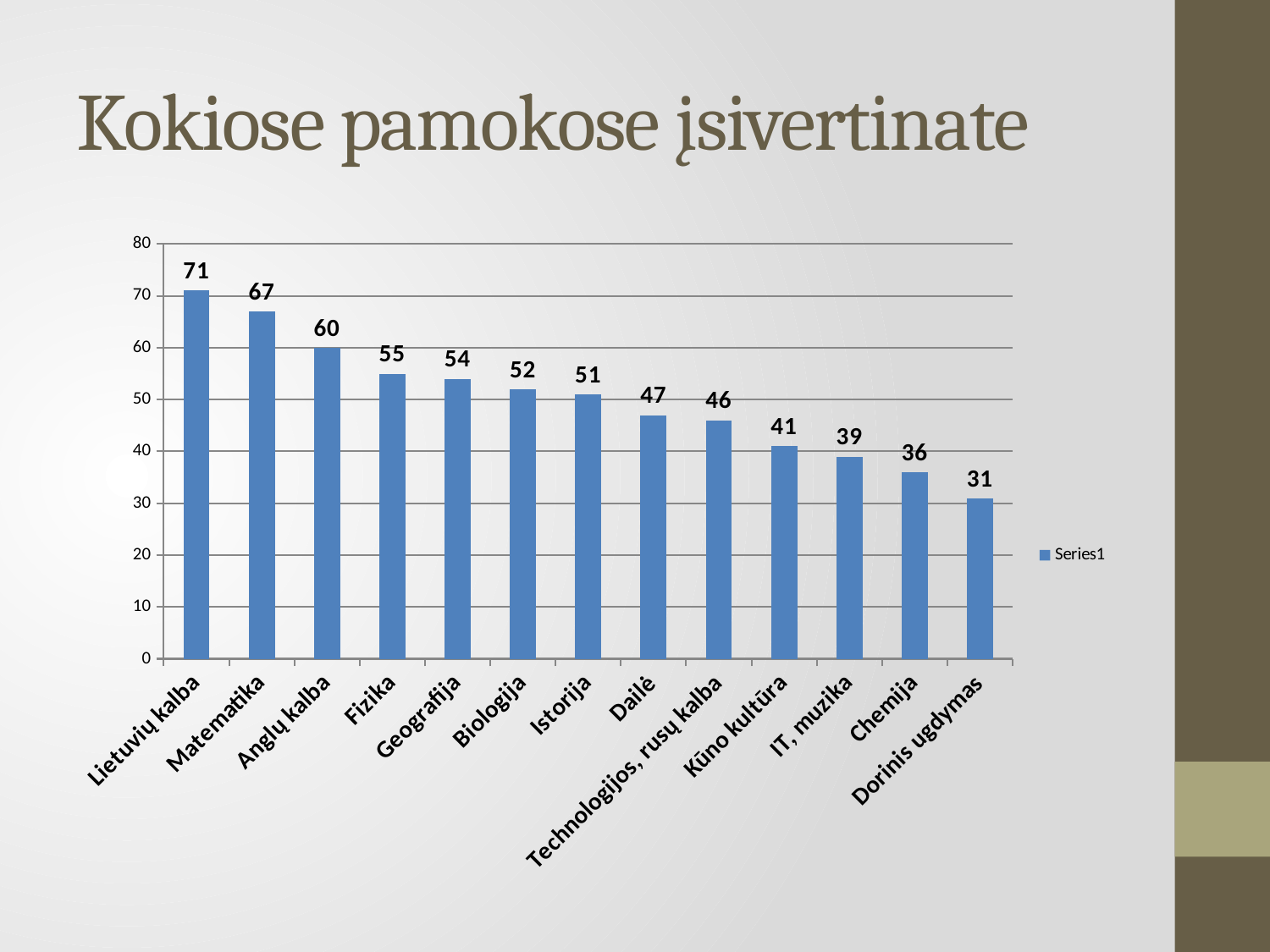
How many series does the legend list? 1 What is the value for Biologija? 52 What is the value for Kūno kultūra? 41 How many categories are shown on the x axis? 13 What kind of chart is shown on the slide? bar chart What is the difference between the values for Matematika and Chemija? 31 Which is larger, the value for Fizika or the value for Dailė? Fizika Which category has the highest value? Lietuvių kalba Which category has the lowest value? Dorinis ugdymas Do the values rise or fall from left to right along the x axis? fall What is the value for Lietuvių kalba? 71 Is the value for Istorija greater or less than 40? greater